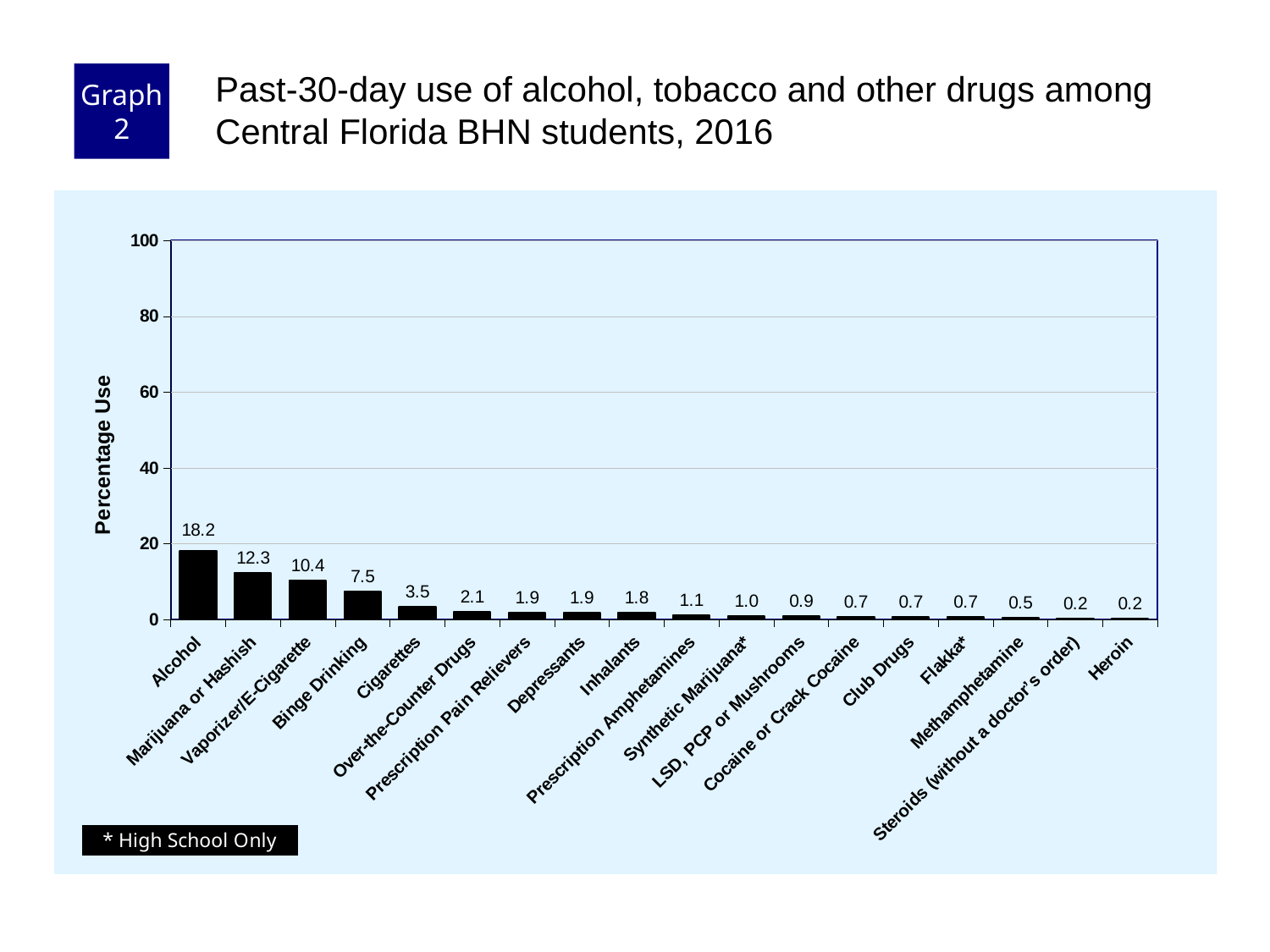
What is the percentage use for Inhalants? 1.8 What type of chart is shown on the slide? Bar chart Is the value for Marijuana or Hashish greater or less than 20? less What is the percentage use for Vaporizer/E-Cigarette? 10.4 What is the difference in percentage use between Alcohol and Marijuana or Hashish? 5.9 Which category has the highest percentage use? Alcohol What is the percentage use for Alcohol? 18.2 What is the difference in percentage use between Binge Drinking and Cigarettes? 4.0 Which has a higher percentage use, Over-the-Counter Drugs or Prescription Amphetamines? Over-the-Counter Drugs What is the percentage use for Methamphetamine? 0.5 How many categories are shown on the x axis? 18 What is the percentage use for Cigarettes? 3.5